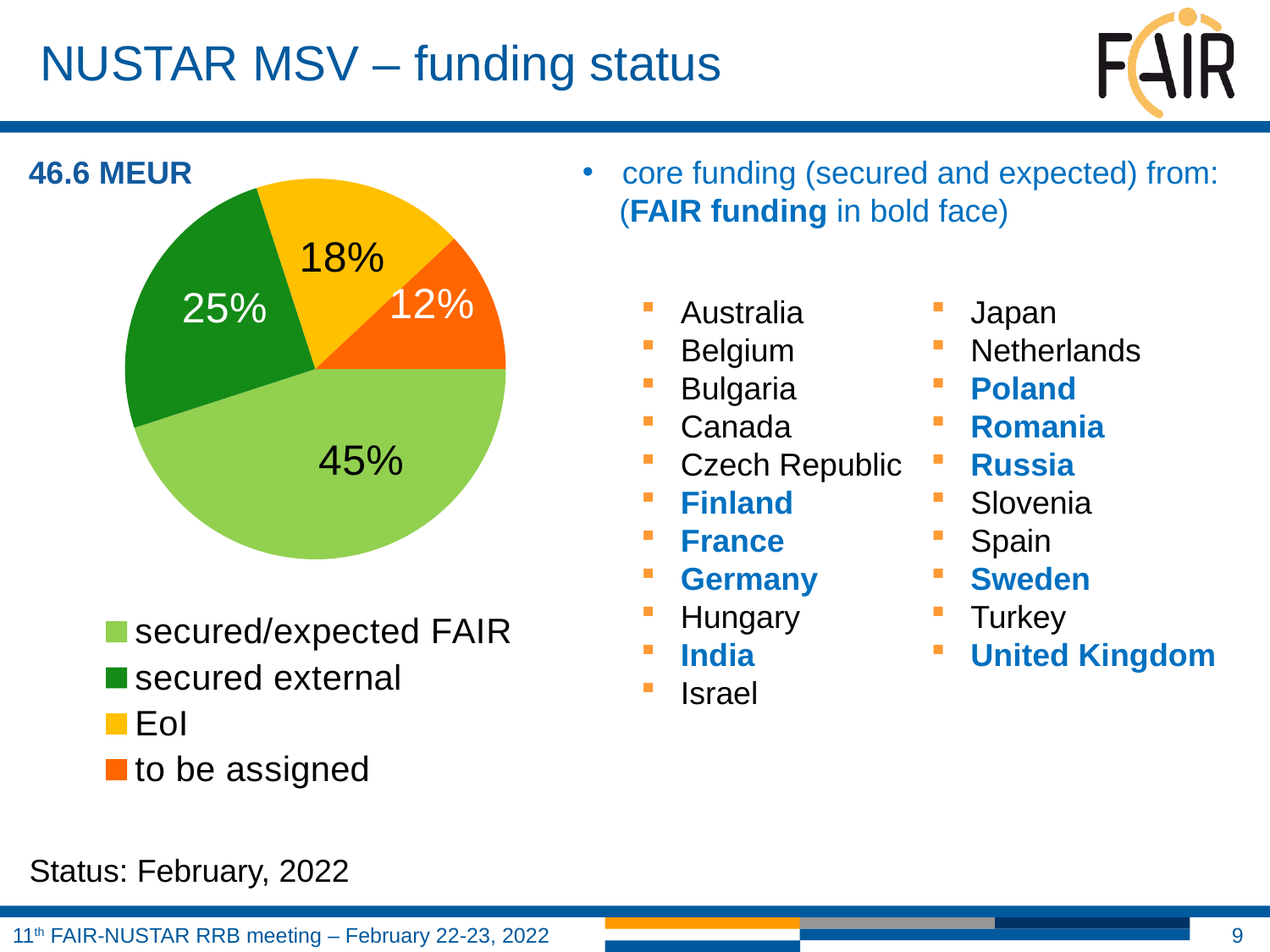
How many entries does the legend list? 4 Which category has the largest slice of the pie? secured/expected FAIR What share of the pie is labelled EoI? 18% What share of the pie is labelled to be assigned? 12% What share of the pie is labelled secured external? 25% How many slices does the pie chart have? 4 Which category has the smallest slice of the pie? to be assigned What total amount in MEUR is shown above the pie chart? 46.6 MEUR Which is larger, the EoI slice or the to be assigned slice? EoI What is the difference in percentage points between the secured/expected FAIR slice and the secured external slice? 20 What kind of chart is shown on the slide? pie chart